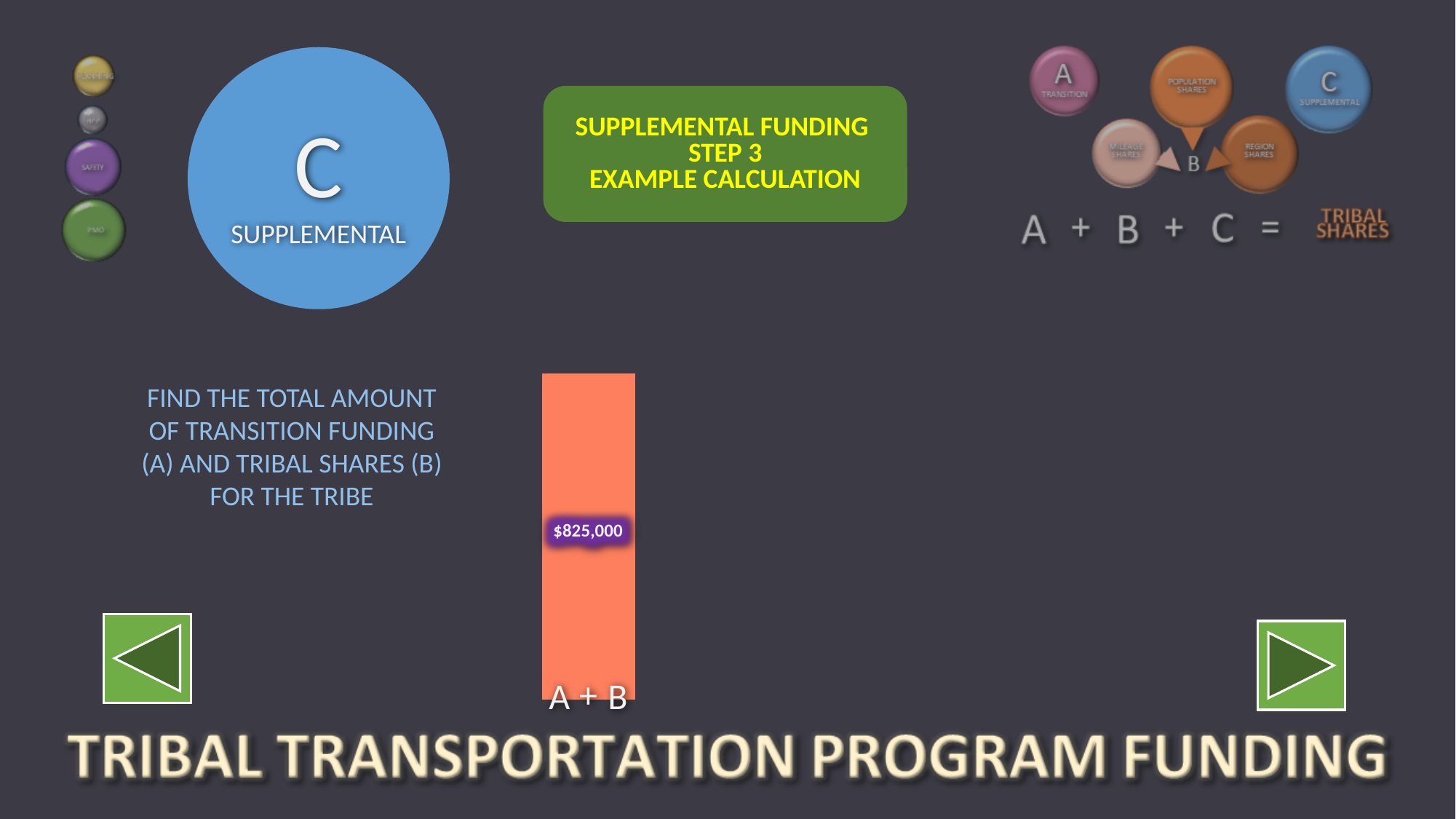
What is the category label under the bar in the chart? A + B What colour is the bar in the chart? orange How many bars are plotted in the chart? 1 What kind of chart is shown on the slide? bar chart What value is shown on the bar labeled A + B? $825,000